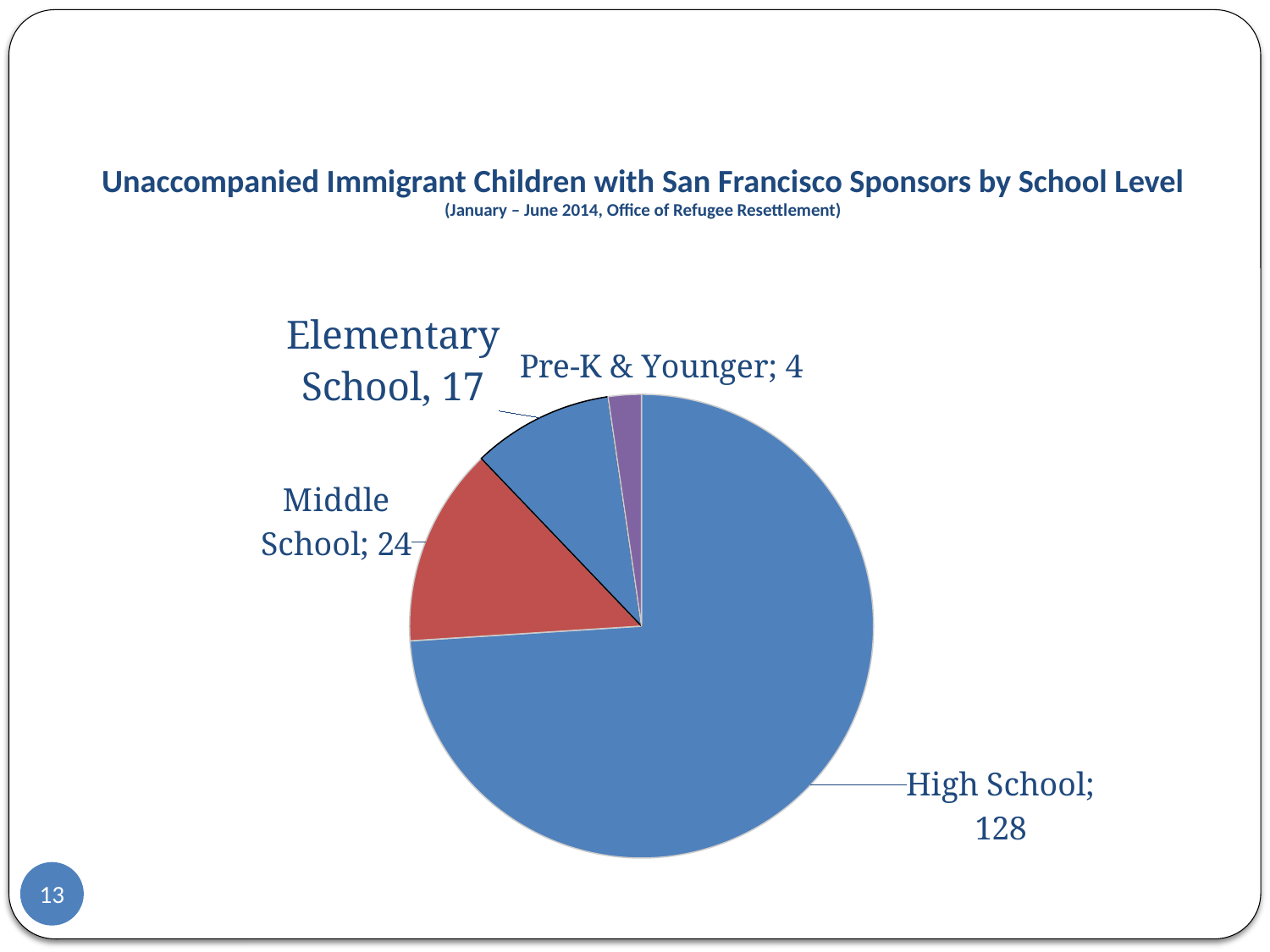
What is the total of all slices in the pie chart? 173 What is the value for Middle School? 24 What is the value for Elementary School? 17 What is the difference between the High School and Middle School values? 104 What kind of chart is shown on the slide? Pie chart Which school level has the smallest slice? Pre-K & Younger What is the value for Pre-K & Younger? 4 What is the title of the chart? Unaccompanied Immigrant Children with San Francisco Sponsors by School Level Which is larger, Middle School or Elementary School? Middle School How many slices does the pie chart have? 4 How many children are in the High School slice? 128 Which school level has the largest slice? High School